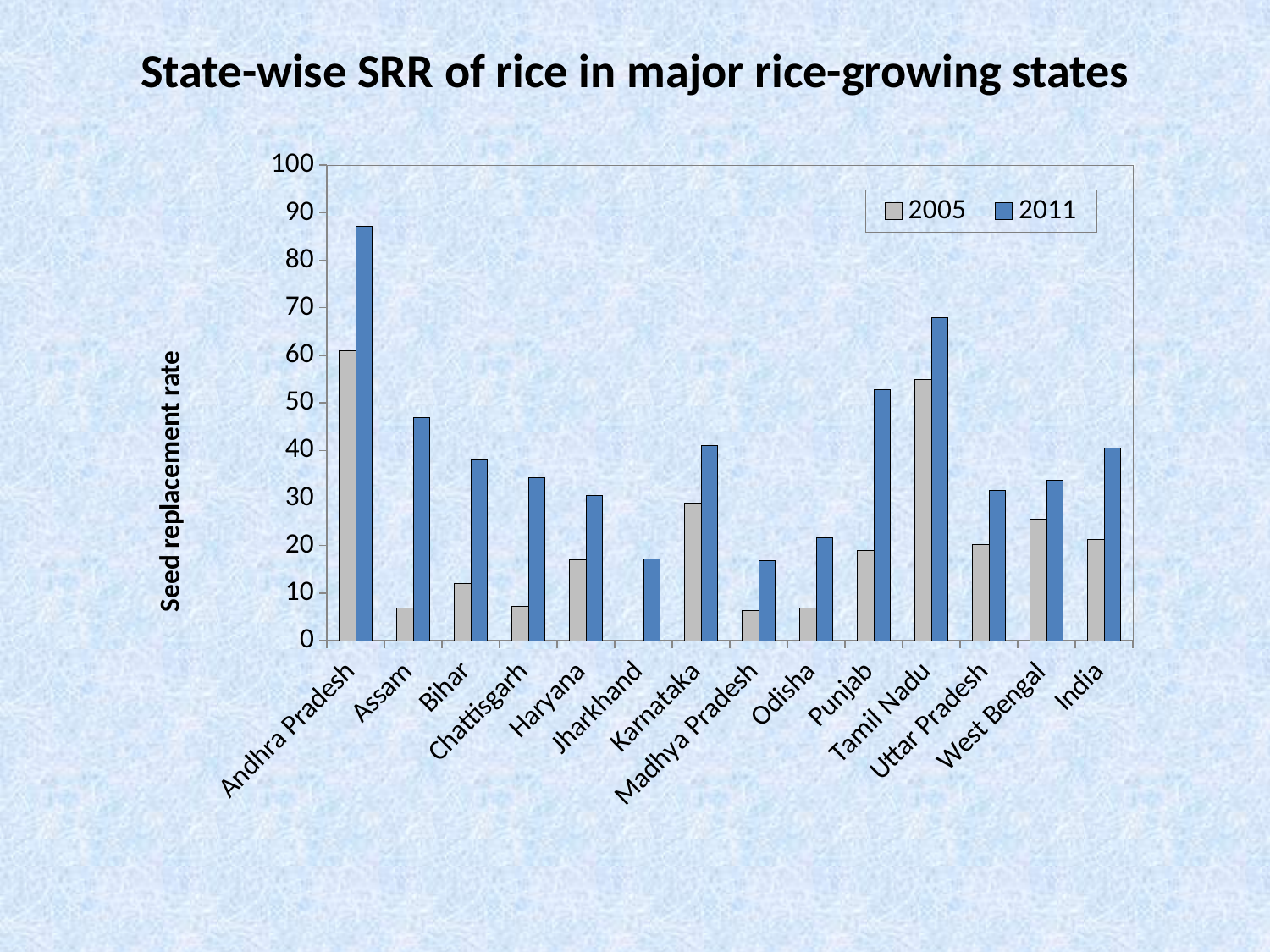
How many states/categories are shown on the x axis? 14 How many series does the legend list? 2 Is the 2011 value for Assam greater or less than 50? less Which state has the highest seed replacement rate in 2011? Andhra Pradesh Which is larger, the 2005 value for Punjab or the 2005 value for Tamil Nadu? Tamil Nadu Which state has the highest seed replacement rate in 2005? Andhra Pradesh Which years are listed in the legend? 2005 and 2011 Is the 2011 value for Tamil Nadu greater or less than 60? greater Is the 2011 value for Andhra Pradesh greater or less than 80? greater Which is larger, the 2011 value for Assam or the 2011 value for Bihar? Assam What type of chart is shown on the slide? Bar chart What is the label of the vertical axis? Seed replacement rate